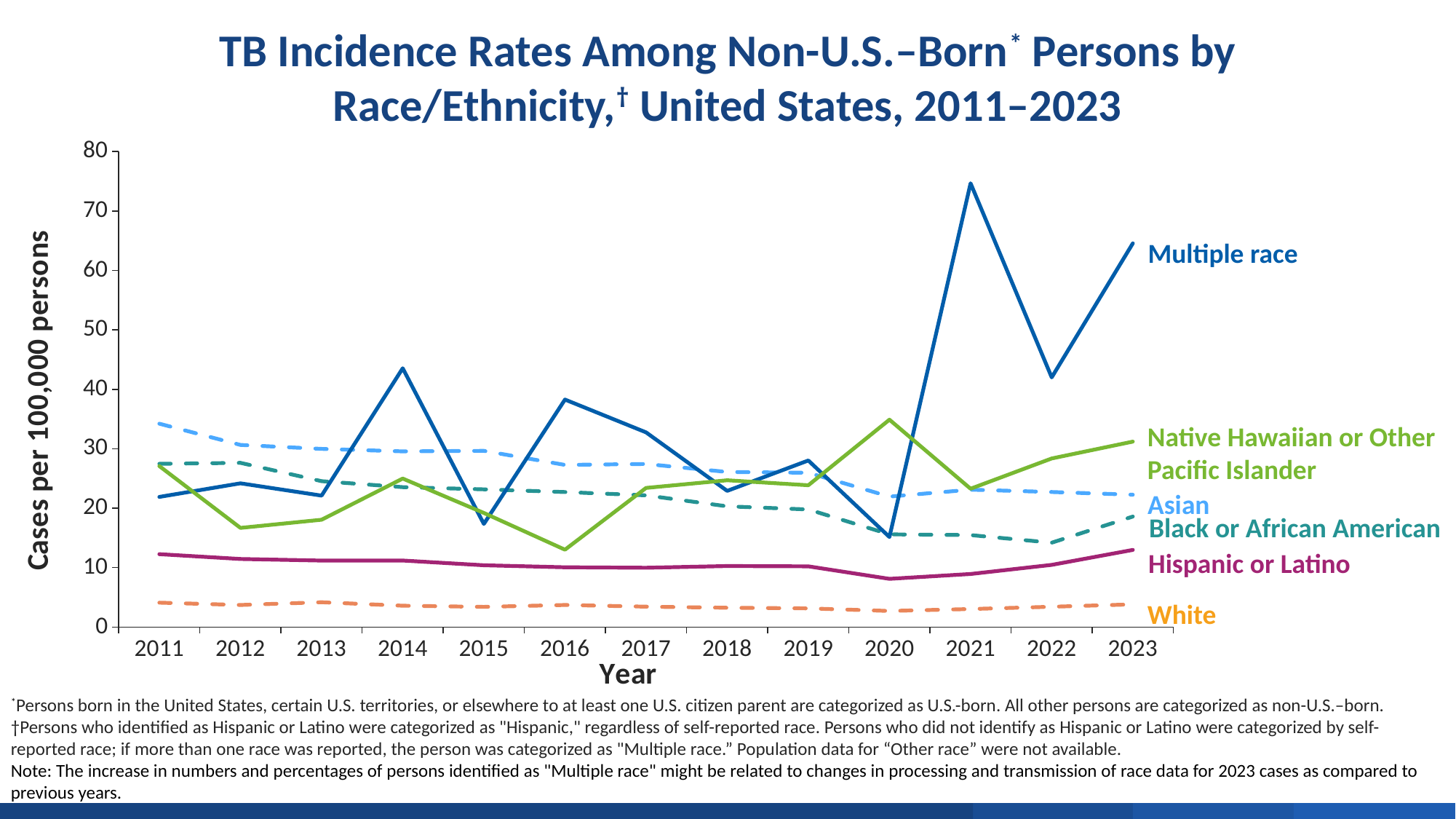
In 2023, which is larger: the value for Multiple race or the value for Native Hawaiian or Other Pacific Islander? Multiple race Does the Asian line rise or fall from 2011 to 2023? fall What kind of chart is shown on the slide? line chart Is the value for Asian in 2011 greater or less than 30? greater Is the value for Multiple race in 2020 greater or less than 20? less Which group has the highest incidence rate in 2021? Multiple race Is the value for Native Hawaiian or Other Pacific Islander in 2020 greater or less than 30? greater How many years are shown along the x axis? 13 Which group has the lowest incidence rate in 2023? White How many race/ethnicity groups are plotted on the chart? 6